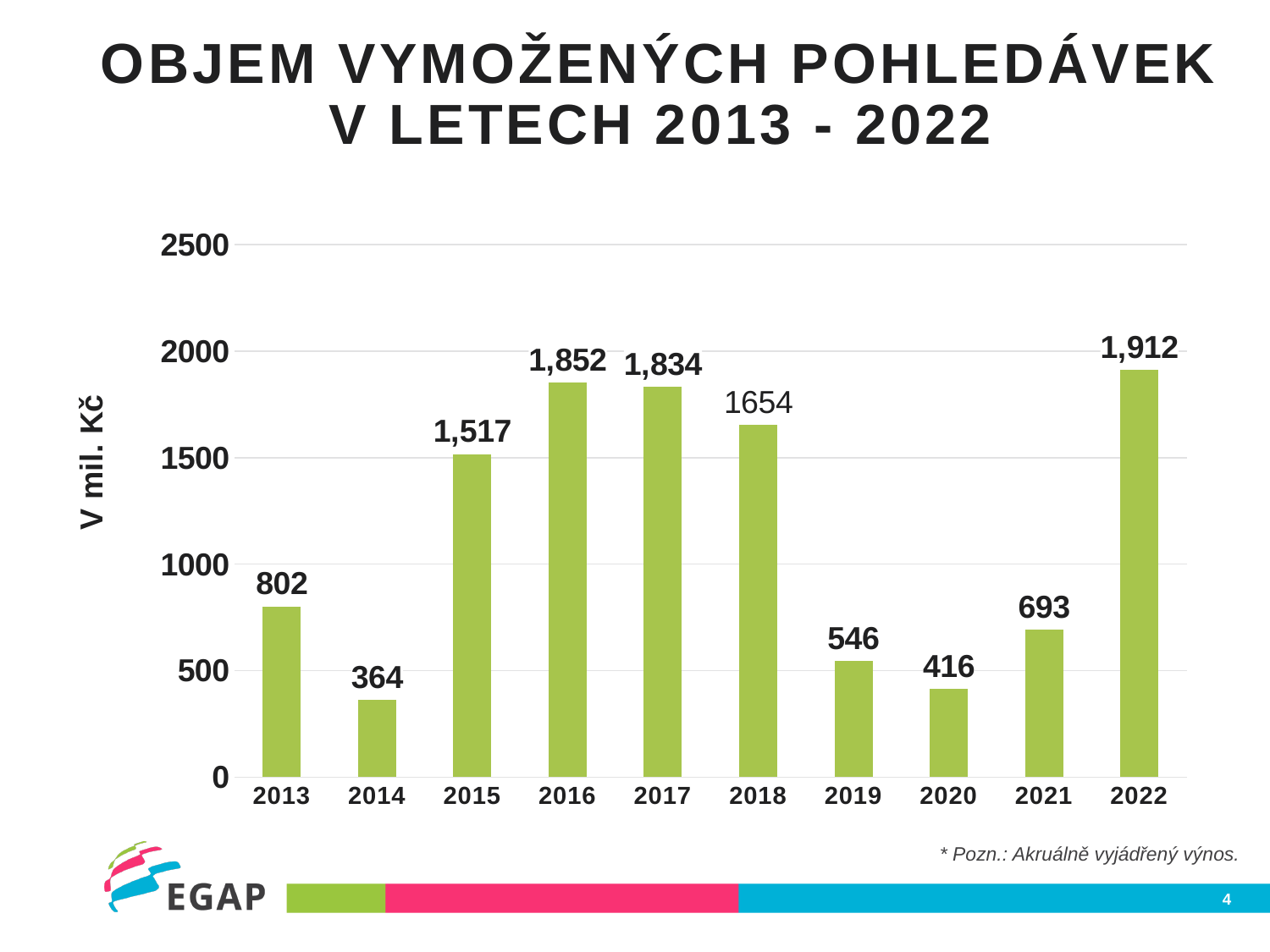
What is the difference between the values for 2022 and 2021? 1,219 What is the value for 2018? 1654 Is the value for 2015 greater or less than 1500? greater Do the values rise or fall from 2018 to 2020? fall What is the value for 2016? 1,852 What kind of chart is shown on the slide? bar chart What is the value for 2020? 416 What is the label of the vertical axis? V mil. Kč Which year has the highest value? 2022 Which is larger, the value for 2013 or the value for 2019? 2013 Which year has the lowest value? 2014 How many years are shown on the x axis? 10